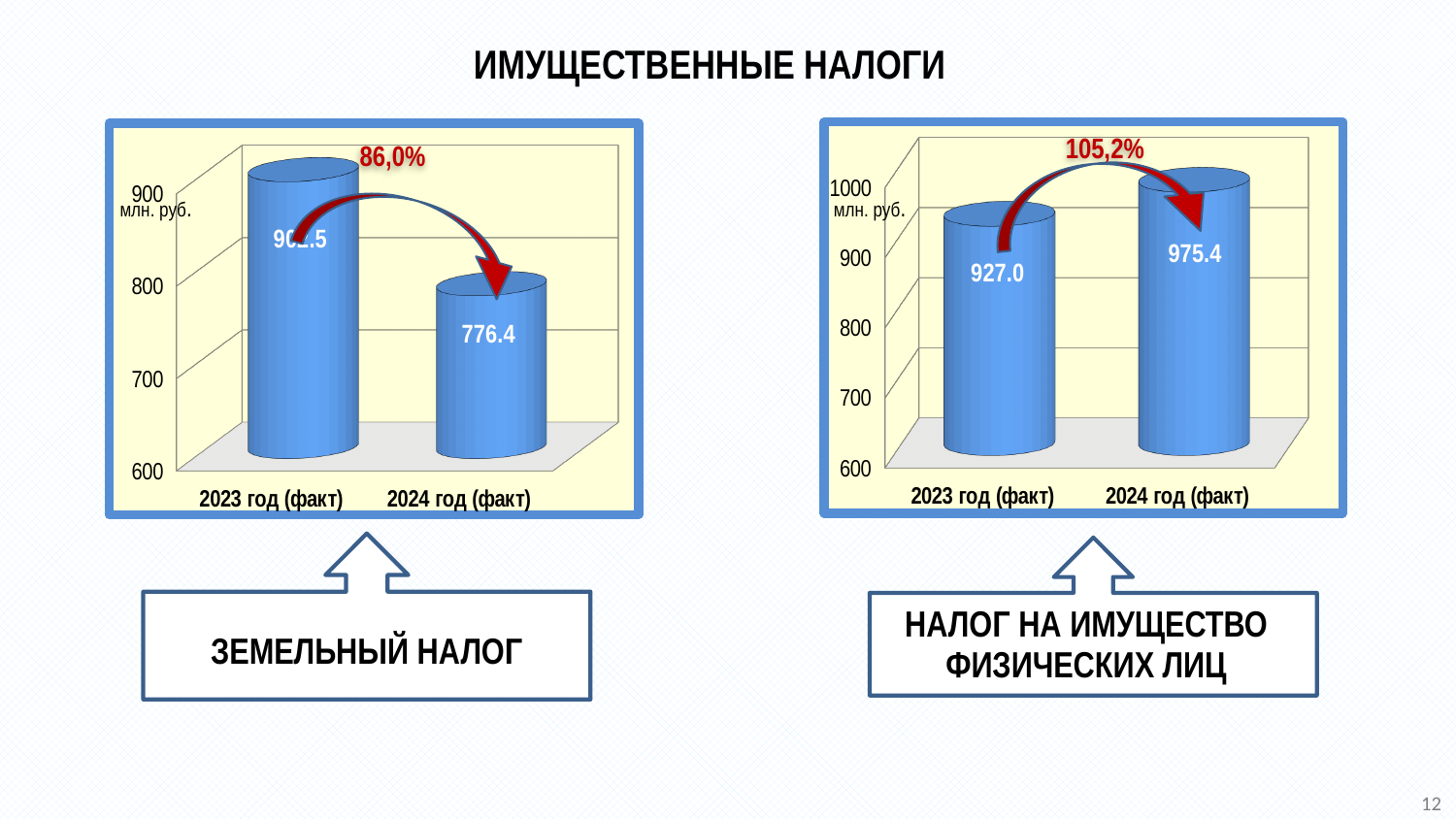
How many categories are shown in the right chart (НАЛОГ НА ИМУЩЕСТВО ФИЗИЧЕСКИХ ЛИЦ)? 2 What percentage is shown above the arrow in the right chart (НАЛОГ НА ИМУЩЕСТВО ФИЗИЧЕСКИХ ЛИЦ)? 105,2% In the left chart (ЗЕМЕЛЬНЫЙ НАЛОГ), which year has the lower value? 2024 год (факт) In the right chart (НАЛОГ НА ИМУЩЕСТВО ФИЗИЧЕСКИХ ЛИЦ), what is the value for 2023 год (факт)? 927.0 In the right chart (НАЛОГ НА ИМУЩЕСТВО ФИЗИЧЕСКИХ ЛИЦ), what is the difference between the 2024 год (факт) and 2023 год (факт) values? 48.4 In the right chart (НАЛОГ НА ИМУЩЕСТВО ФИЗИЧЕСКИХ ЛИЦ), what is the value for 2024 год (факт)? 975.4 In the right chart (НАЛОГ НА ИМУЩЕСТВО ФИЗИЧЕСКИХ ЛИЦ), do the values rise or fall from 2023 to 2024? rise What kind of chart is the left chart (ЗЕМЕЛЬНЫЙ НАЛОГ)? bar chart In the right chart (НАЛОГ НА ИМУЩЕСТВО ФИЗИЧЕСКИХ ЛИЦ), which year has the higher value? 2024 год (факт) In the left chart (ЗЕМЕЛЬНЫЙ НАЛОГ), do the values rise or fall from 2023 to 2024? fall In the left chart (ЗЕМЕЛЬНЫЙ НАЛОГ), is the value for 2023 год (факт) greater or less than 900? greater In the left chart (ЗЕМЕЛЬНЫЙ НАЛОГ), what is the value for 2024 год (факт)? 776.4